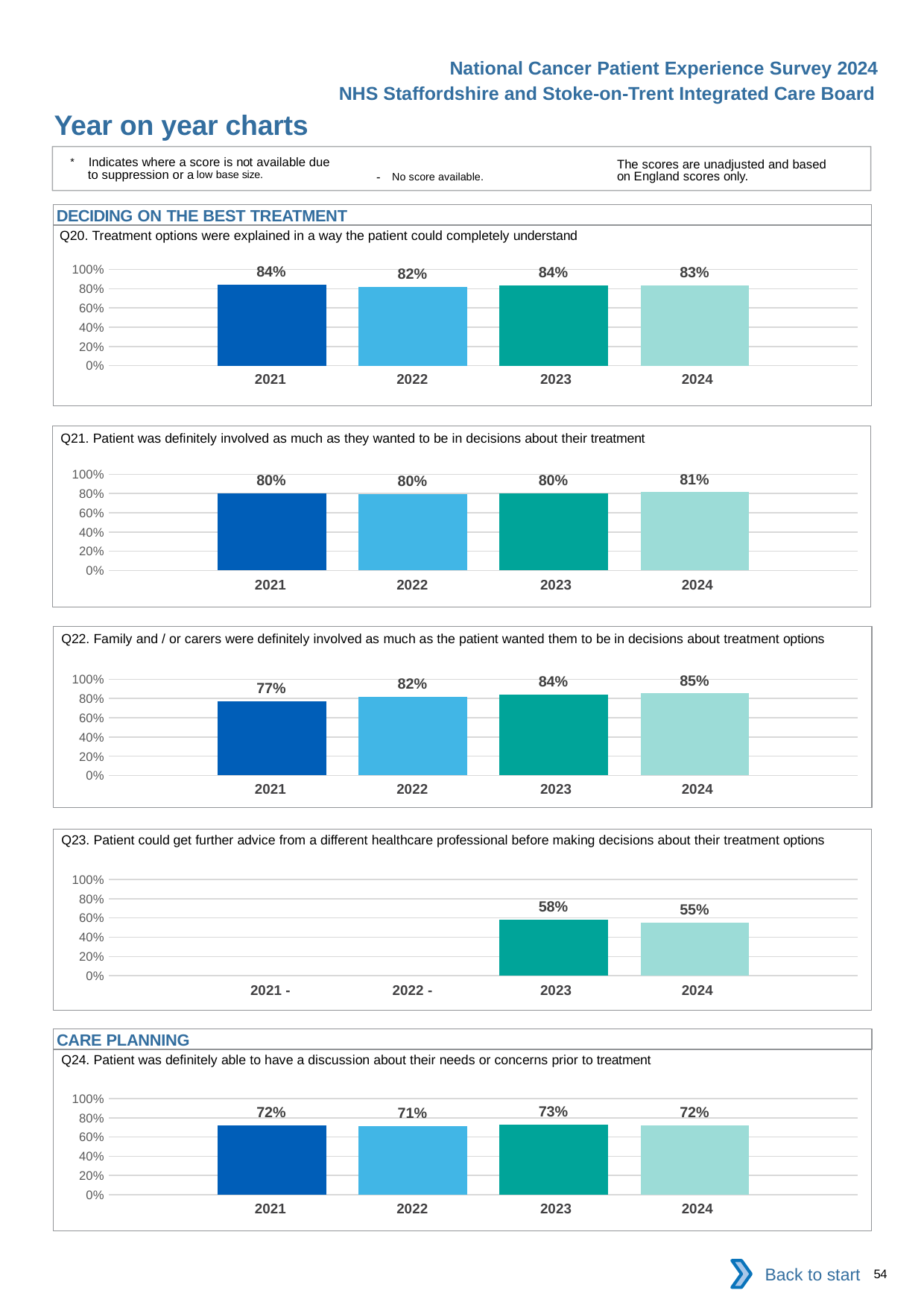
In the Q23 chart (Patient could get further advice from a different healthcare professional), how many years have a score shown? 2 In the Q24 chart (Patient was definitely able to have a discussion about their needs or concerns prior to treatment), is the value for 2022 larger or smaller than the value for 2023? smaller In the Q20 chart (Treatment options were explained in a way the patient could completely understand), what is the value for 2022? 82% In the Q23 chart (Patient could get further advice from a different healthcare professional), what is the difference between the 2023 and 2024 values? 3 percentage points In the Q22 chart (Family and / or carers were definitely involved as much as the patient wanted them to be), what is the difference between the 2024 and 2021 values? 8 percentage points In the Q22 chart (Family and / or carers were definitely involved as much as the patient wanted them to be), which year has the lowest value? 2021 In the Q24 chart (Patient was definitely able to have a discussion about their needs or concerns prior to treatment), which year has the highest value? 2023 In the Q22 chart (Family and / or carers were definitely involved as much as the patient wanted them to be), do the values rise or fall from 2021 to 2024? rise In the Q23 chart (Patient could get further advice from a different healthcare professional), what is the value for 2023? 58% In the Q21 chart (Patient was definitely involved as much as they wanted to be in decisions about their treatment), what is the value for 2024? 81% What kind of chart is used for Q20 (Treatment options were explained in a way the patient could completely understand)? bar chart In the Q22 chart (Family and / or carers were definitely involved as much as the patient wanted them to be), which year has the highest value? 2024